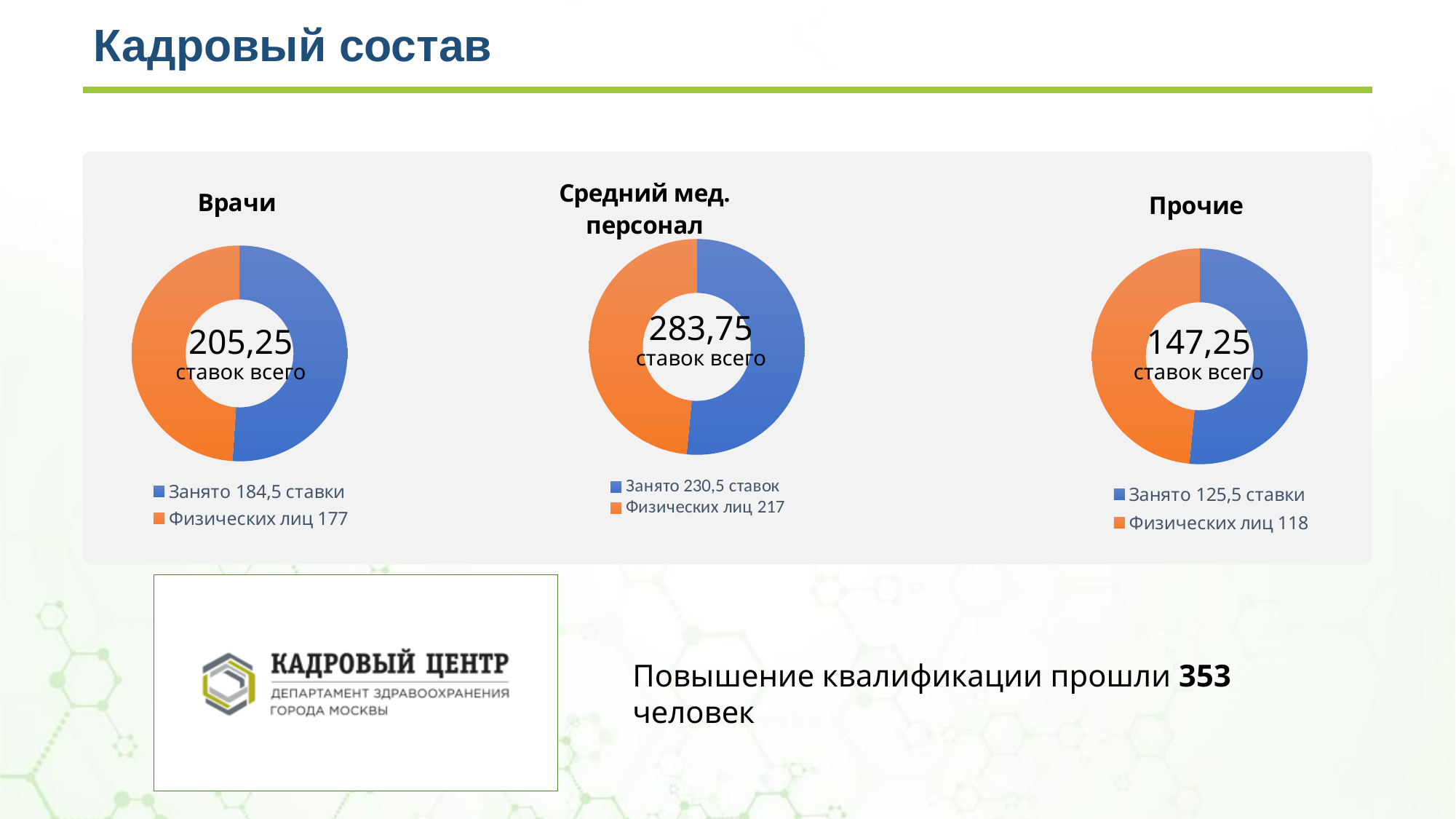
What total number of positions (ставок всего) is shown in the centre of the "Средний мед. персонал" chart? 283,75 In the "Врачи" chart, how many positions are shown as occupied (Занято)? 184,5 ставки In the "Врачи" chart, which is larger: Занято or Физических лиц? Занято In the "Средний мед. персонал" chart, how many individuals (Физических лиц) are shown? 217 What kind of chart is used for "Врачи"? Doughnut (pie) chart In the "Прочие" chart, how many individuals (Физических лиц) are shown? 118 In the "Средний мед. персонал" chart, what is the difference between Занято (230,5) and Физических лиц (217)? 13,5 What total number of positions (ставок всего) is shown in the centre of the "Прочие" chart? 147,25 How many legend entries does the "Прочие" chart have? 2 In the "Врачи" chart, how many individuals (Физических лиц) are shown? 177 In the "Средний мед. персонал" chart, how many positions are shown as occupied (Занято)? 230,5 ставок In the "Прочие" chart, how many positions are shown as occupied (Занято)? 125,5 ставки